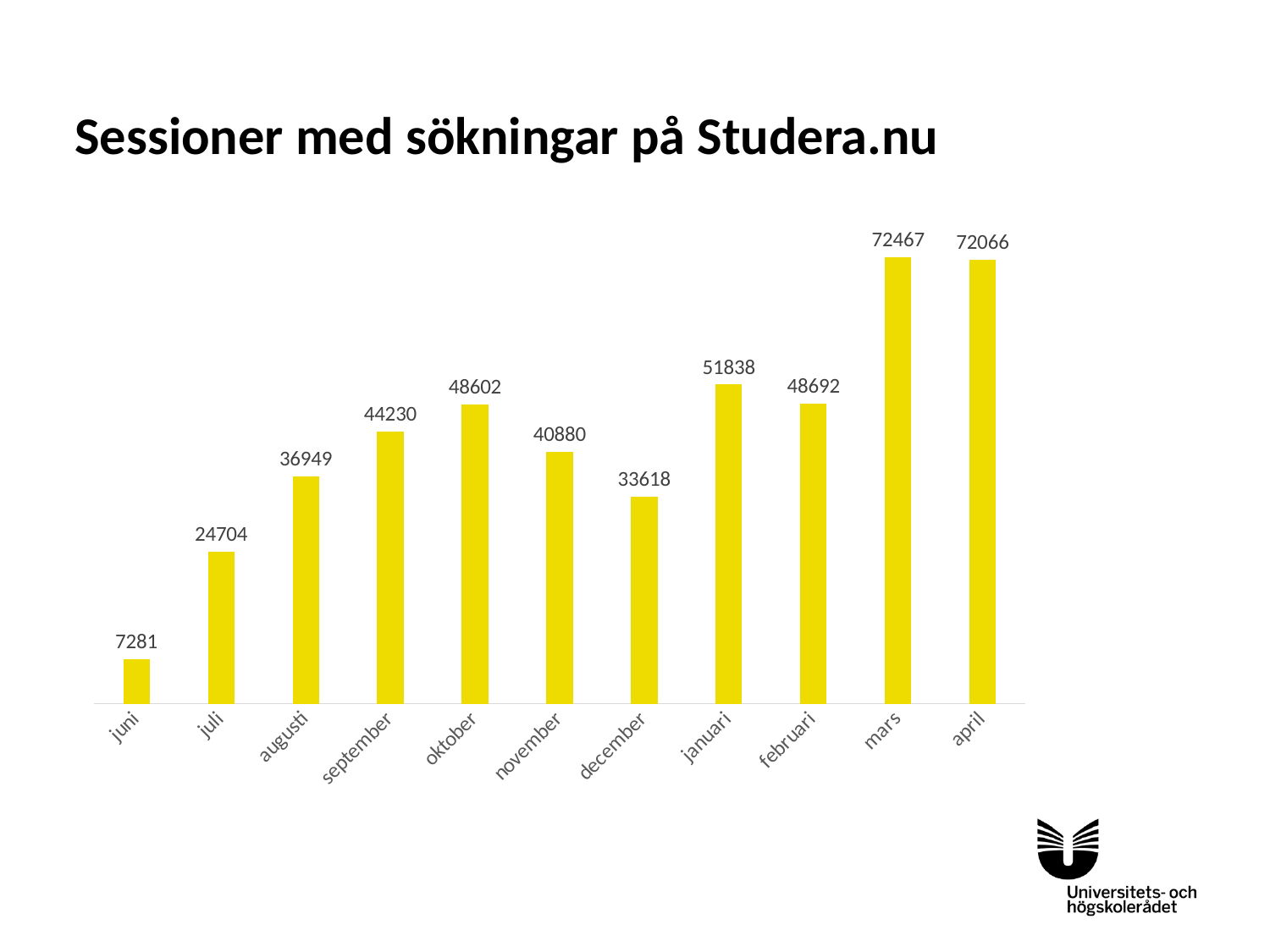
Which month has the lowest value? juni Which month has the highest value? mars How many months are shown on the x axis? 11 Do the values generally rise or fall from juni to april? rise What is the difference between the values for mars and april? 401 Which is larger, the value for november or the value for december? november What is the title of the chart? Sessioner med sökningar på Studera.nu What is the value for januari? 51838 What kind of chart is shown on the slide? bar chart What is the difference between the values for januari and december? 18220 What is the value for juni? 7281 What is the value for oktober? 48602